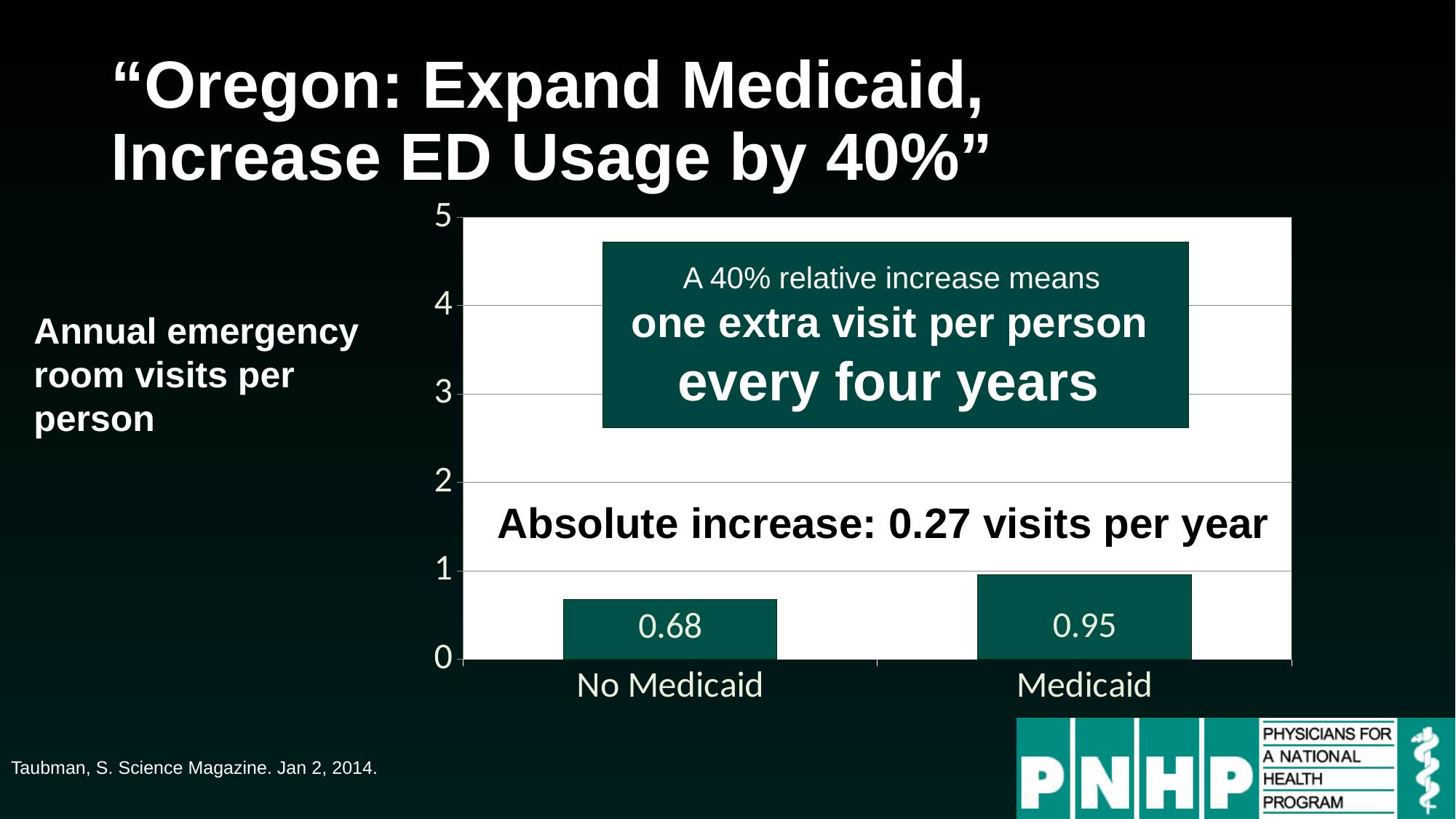
What does the chart measure, according to the label to its left? Annual emergency room visits per person How many categories are shown on the x axis? 2 What is the value for No Medicaid? 0.68 What is the difference between the Medicaid and No Medicaid values? 0.27 Which category has the higher value? Medicaid Which category has the lower value? No Medicaid What is the value for Medicaid? 0.95 Is the value for Medicaid greater or less than 1? less Do the values rise or fall from No Medicaid to Medicaid? rise Is the value for No Medicaid greater or less than 1? less What is the highest value shown on the y axis? 5 What kind of chart is shown on the slide? bar chart